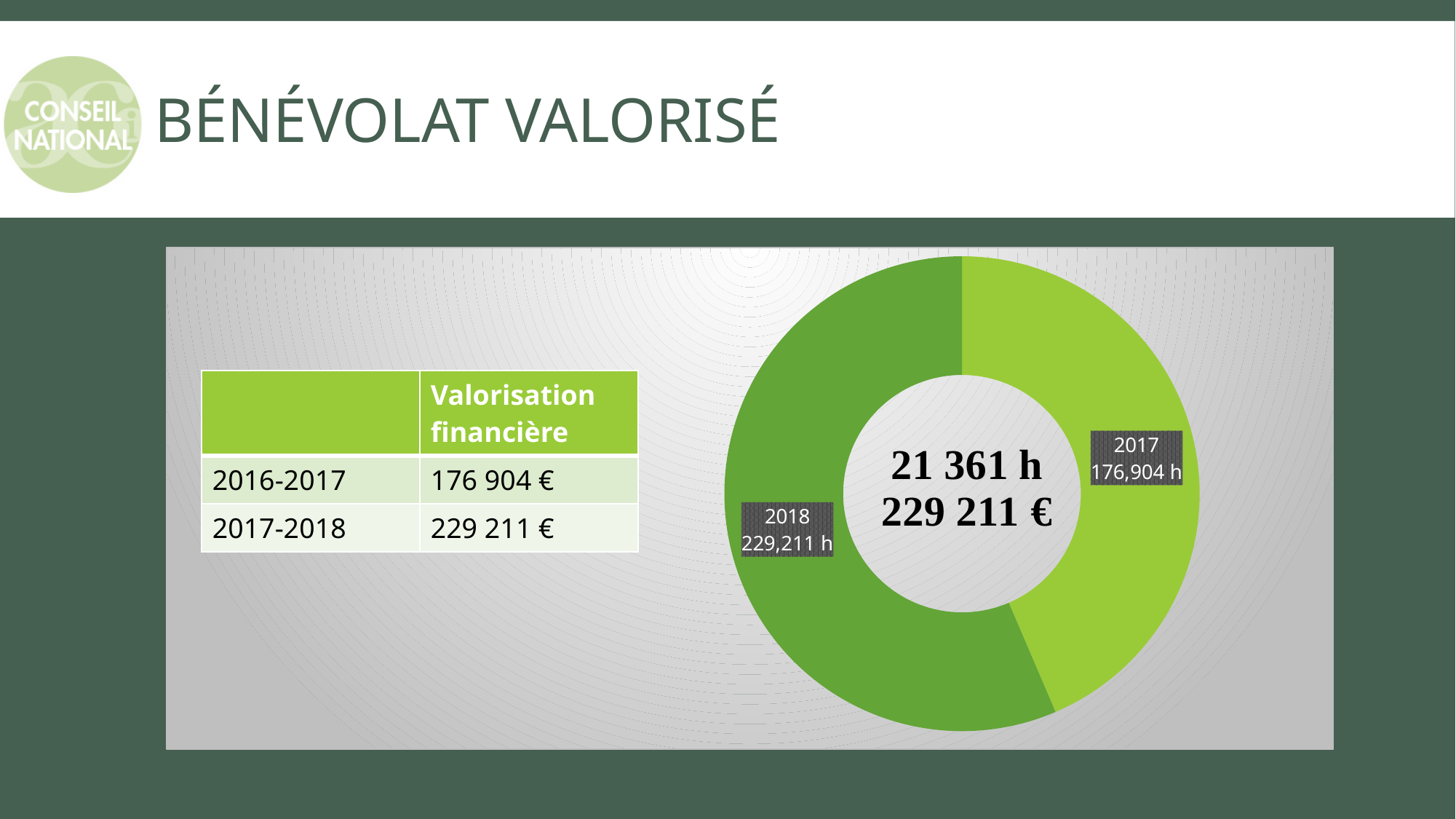
What value is shown for the 2017 slice of the doughnut chart? 176,904 h What kind of chart is shown on the slide? Doughnut chart What colour is the 2018 slice of the doughnut chart? Dark green How many slices does the doughnut chart have? 2 What value is shown for the 2018 slice of the doughnut chart? 229,211 h What is the difference between the 2018 and 2017 values in the doughnut chart? 52,307 h Which slice of the doughnut chart is the smallest? 2017 Which is larger in the doughnut chart, the 2017 slice or the 2018 slice? 2018 What text is printed in the centre of the doughnut chart? 21 361 h 229 211 € Which slice of the doughnut chart is the largest? 2018 What is the total of the two slices in the doughnut chart? 406,115 h